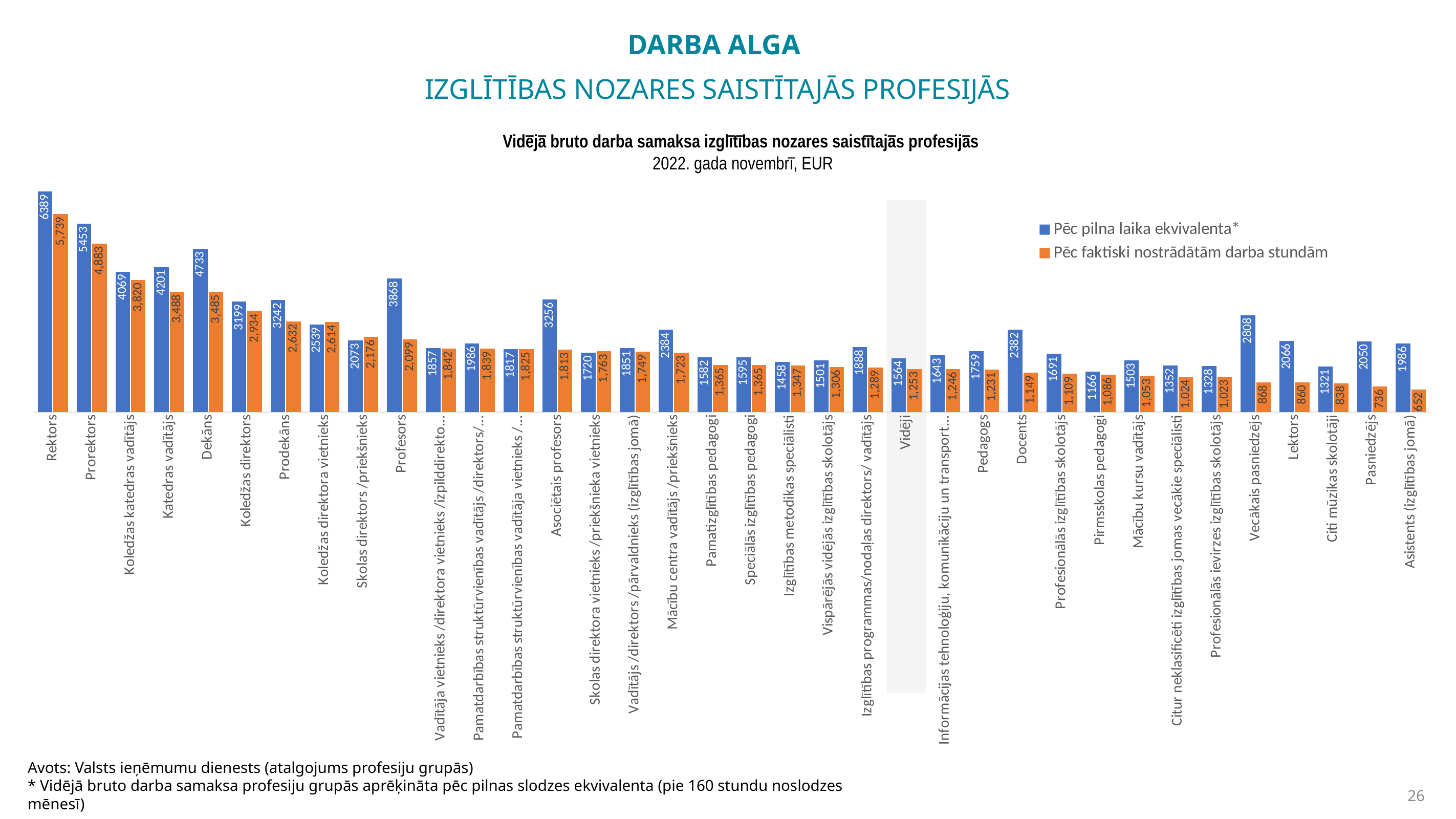
Which has the larger 'Pēc pilna laika ekvivalenta*' value, Profesors or Asociētais profesors? Profesors What is the 'Pēc pilna laika ekvivalenta*' value for Vidēji? 1564 What kind of chart is shown on the slide? Bar chart What is the difference between the 'Pēc pilna laika ekvivalenta*' and 'Pēc faktiski nostrādātām darba stundām' values for Vecākais pasniedzējs? 1940 Which profession has the highest 'Pēc pilna laika ekvivalenta*' value? Rektors What is the value for Rektors in the 'Pēc pilna laika ekvivalenta*' series? 6389 Do the 'Pēc faktiski nostrādātām darba stundām' values rise or fall from left to right along the x axis? Fall What is the 'Pēc faktiski nostrādātām darba stundām' value for Docents? 1,149 How many series does the legend list? 2 Which profession has the lowest 'Pēc faktiski nostrādātām darba stundām' value? Asistents (izglītības jomā) What is the value for Dekāns in the 'Pēc faktiski nostrādātām darba stundām' series? 3,485 What is the difference between the two series values for Rektors? 650